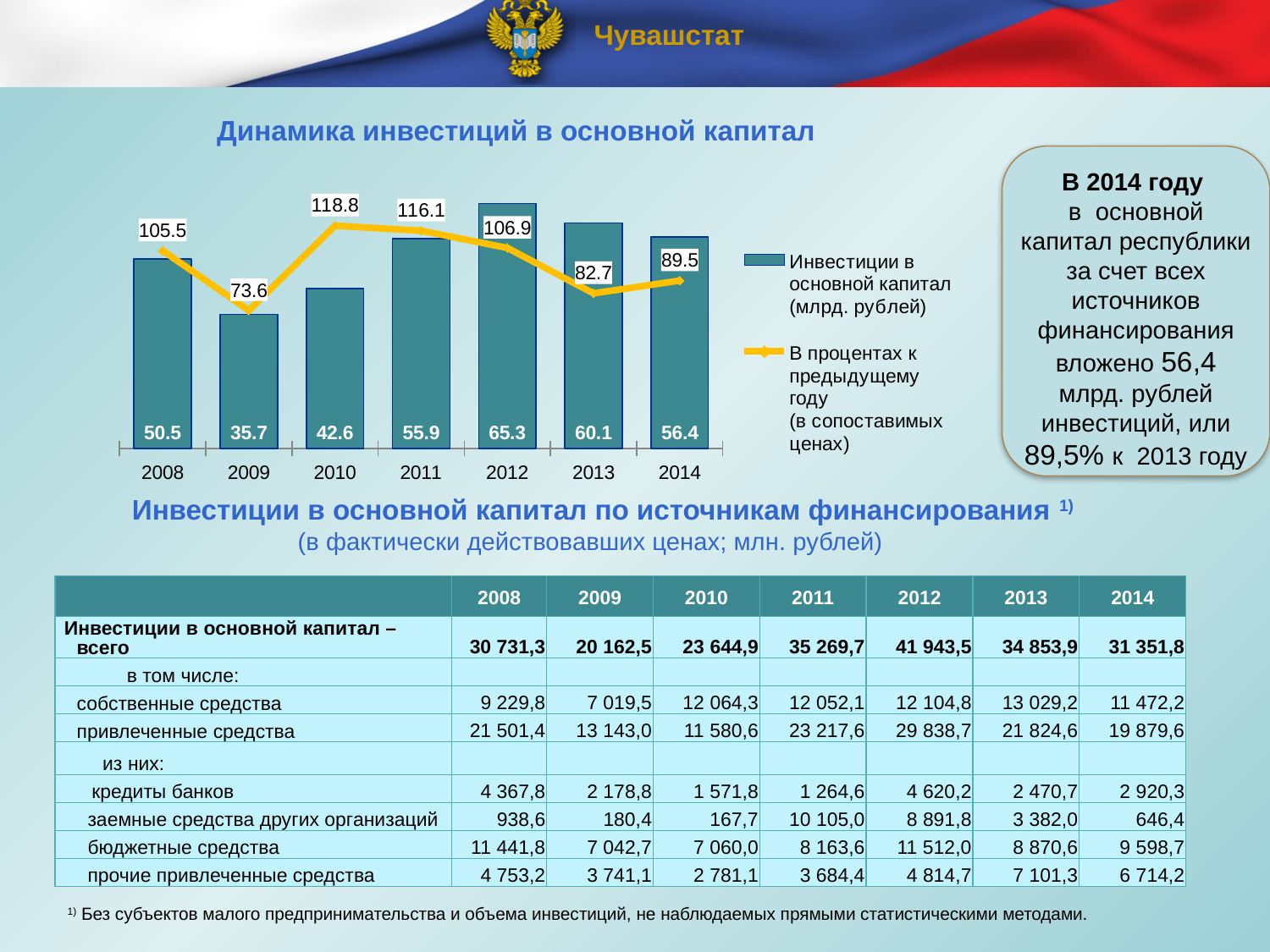
Which year has the larger value of investments in fixed capital (млрд. рублей): 2011 or 2014? 2014 How many years are shown on the x axis of the chart? 7 What kind of chart is used to show investments in fixed capital (млрд. рублей)? bar chart How many series does the chart legend list? 2 What is the value of investments in fixed capital (млрд. рублей) for 2009? 35.7 What is the value of the line series 'В процентах к предыдущему году' for 2010? 118.8 What is the title of the chart? Динамика инвестиций в основной капитал Which year has the lowest value of the series 'В процентах к предыдущему году'? 2009 What is the difference between the investments in fixed capital (млрд. рублей) in 2012 and 2013? 5.2 Which year has the highest value of investments in fixed capital (млрд. рублей)? 2012 Do the values of investments in fixed capital (млрд. рублей) rise or fall from 2012 to 2014? fall What is the value of investments in fixed capital (млрд. рублей) for 2012? 65.3